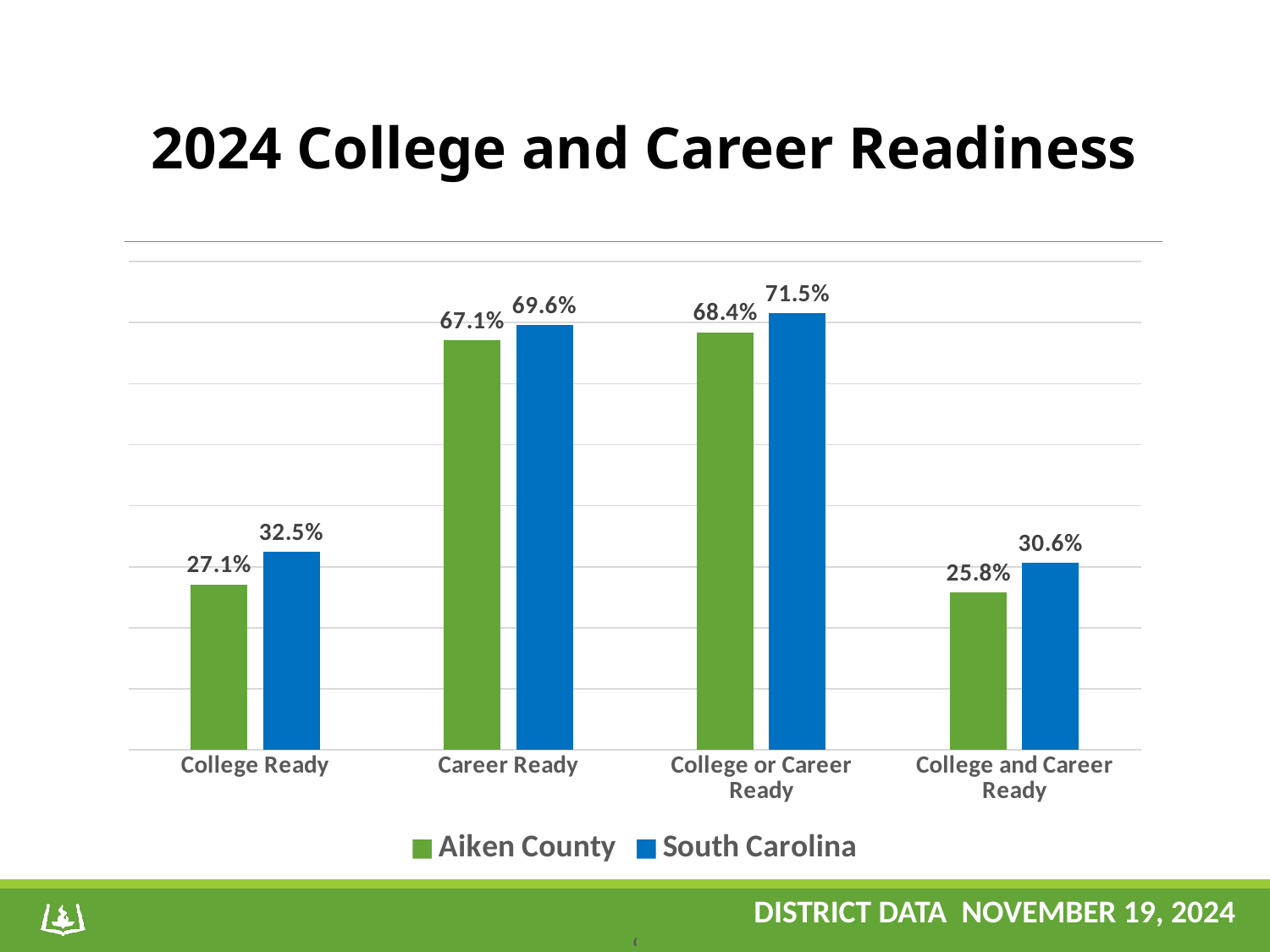
How many series does the legend list? 2 How many categories are shown on the x axis? 4 Which category has the highest South Carolina value? College or Career Ready What is the South Carolina value for College and Career Ready? 30.6% What is the difference between the South Carolina and Aiken County values for College Ready? 5.4% What is the South Carolina value for Career Ready? 69.6% What is the Aiken County value for College Ready? 27.1% What is the difference between the South Carolina and Aiken County values for College or Career Ready? 3.1% Which category has the lowest Aiken County value? College and Career Ready Which is larger for Career Ready: Aiken County or South Carolina? South Carolina Which colour represents Aiken County in the chart? Green What kind of chart is shown on the slide? Bar chart